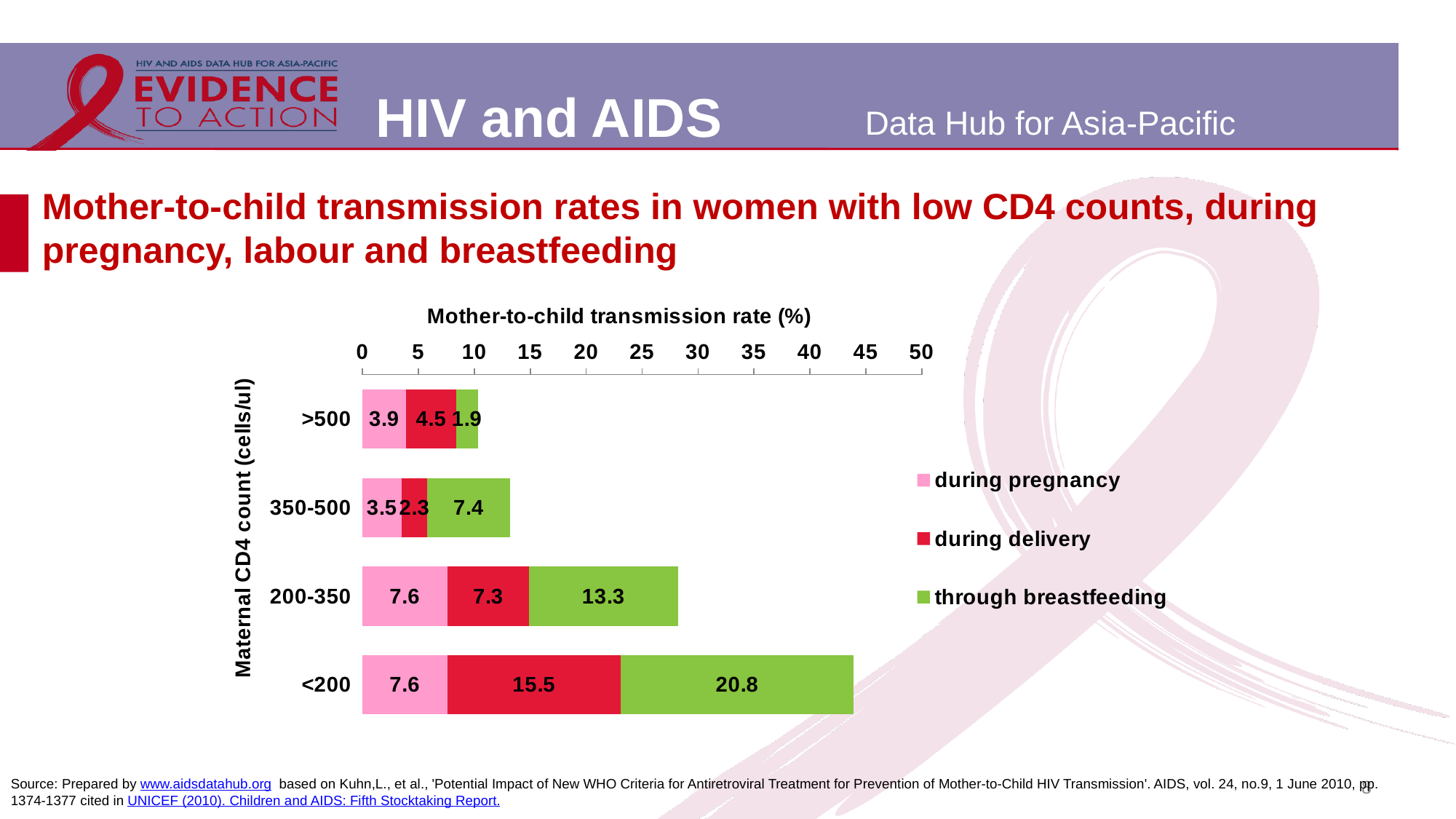
What is the mother-to-child transmission rate through breastfeeding for women with a CD4 count below 200 cells/ul? 20.8 What is the difference between the during-delivery transmission rates for the <200 and 200-350 groups? 8.2 What is the transmission rate during pregnancy for the >500 CD4 count group? 3.9 What is the transmission rate during delivery for the 200-350 CD4 count group? 7.3 How many series does the legend list? 3 Which CD4 count group has the lowest transmission rate during delivery? 350-500 What type of chart is shown on the slide? Stacked bar chart Is the transmission rate through breastfeeding higher for the 350-500 group or the >500 group? 350-500 How many CD4 count categories are shown on the chart? 4 What is the total mother-to-child transmission rate for the <200 CD4 count group? 43.9 What is the total mother-to-child transmission rate for the >500 CD4 count group? 10.3 Which CD4 count group has the highest transmission rate through breastfeeding? <200